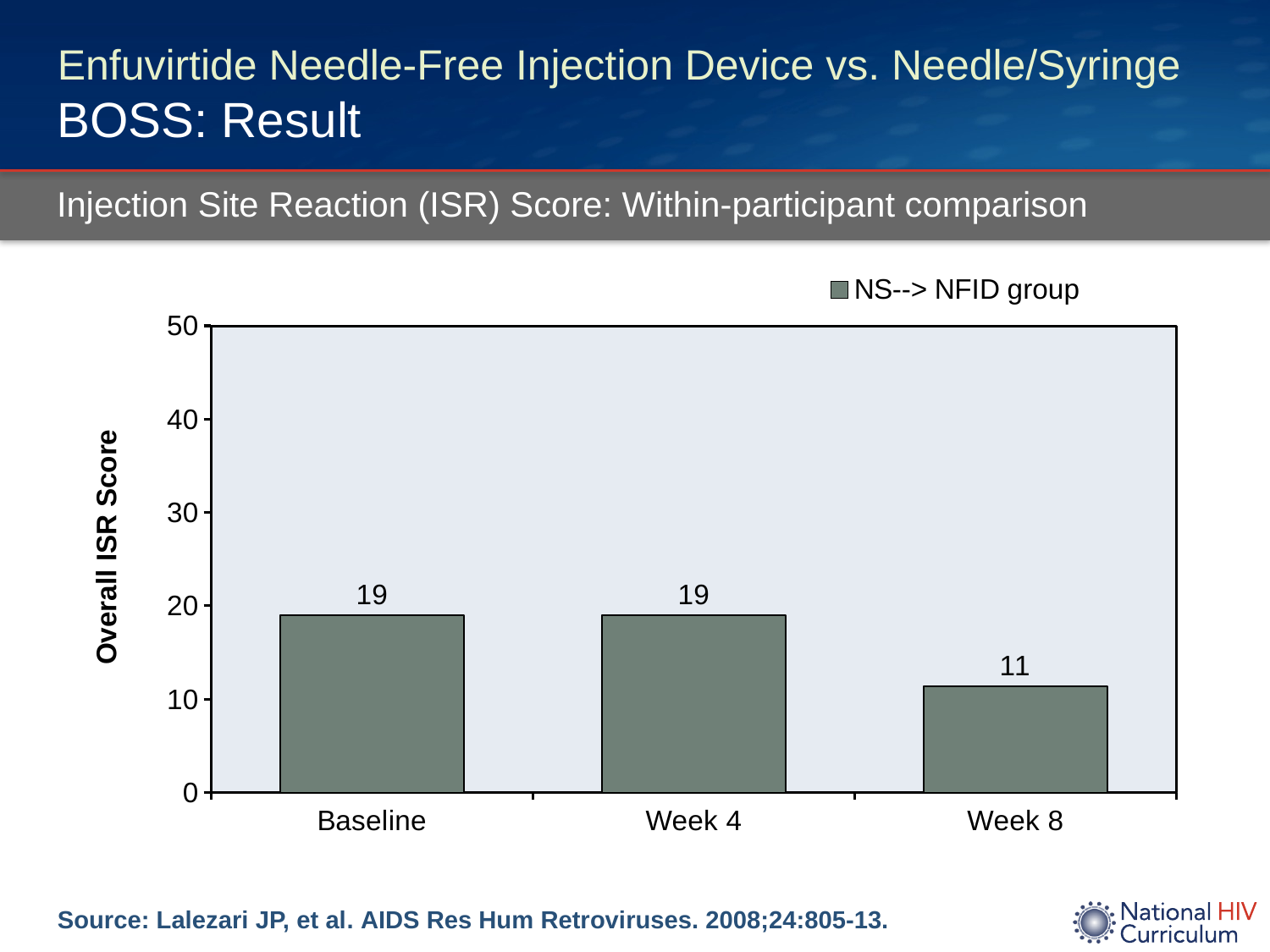
Is the Overall ISR Score at Week 8 greater or less than 20? less Which is larger, the Overall ISR Score at Baseline or at Week 8? Baseline What is the Overall ISR Score at Week 8? 11 What is the name of the series listed in the legend? NS--> NFID group Which time point has the lowest Overall ISR Score? Week 8 What kind of chart is shown on the slide? Bar chart Does the Overall ISR Score rise or fall from Week 4 to Week 8? Fall How many series does the legend list? 1 What is the Overall ISR Score at Week 4? 19 What is the Overall ISR Score at Baseline? 19 How many time points are shown on the x axis? 3 What is the difference between the Overall ISR Score at Week 4 and at Week 8? 8